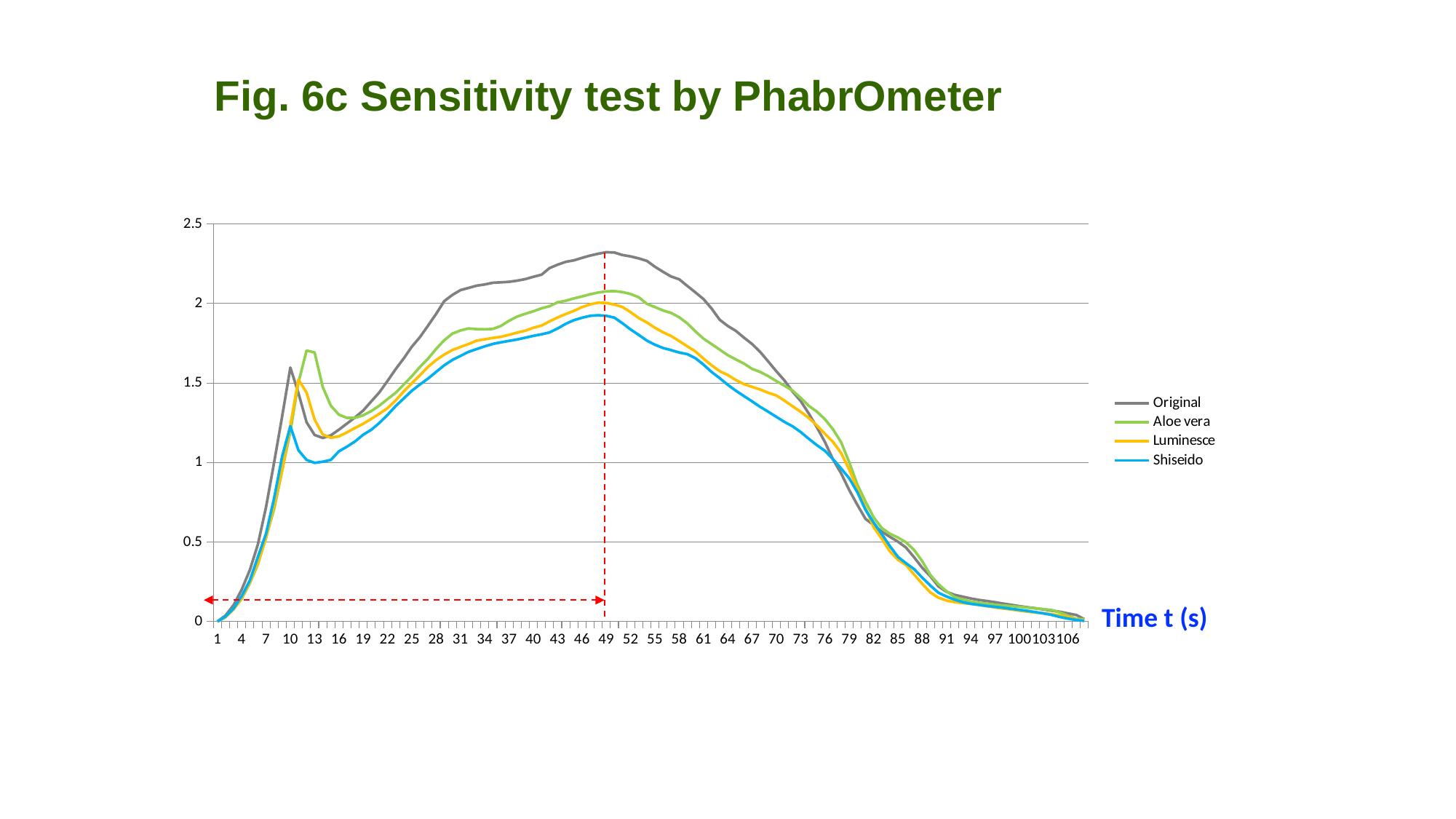
What is the label of the x axis? Time t (s) At time 49, which is larger: the value for Original or the value for Shiseido? Original Which series has the lowest peak value? Shiseido Which series reaches the highest peak value? Original Do the values for all series rise or fall between time 49 and time 106? fall What is the title of the chart? Fig. 6c Sensitivity test by PhabrOmeter What kind of chart is shown on the slide? Line chart Is the value for Original at time 49 greater or less than 2? greater Is the value for Shiseido at time 49 greater or less than 2? less Is the value for Original at time 91 greater or less than 0.5? less How many series does the legend list? 4